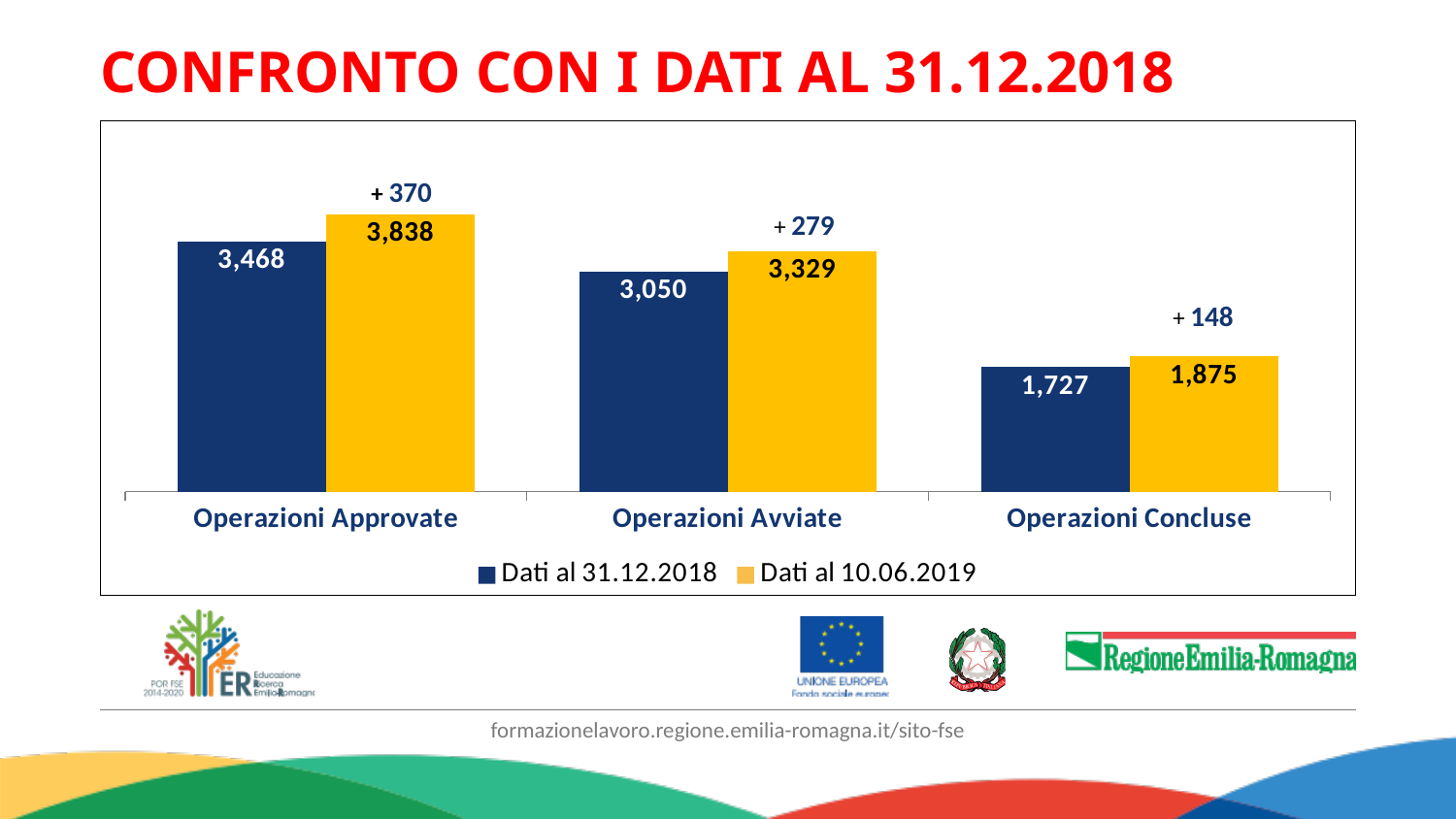
Which category has the lowest value in the Dati al 31.12.2018 series? Operazioni Concluse What is the value for Operazioni Approvate in the Dati al 31.12.2018 series? 3,468 Which is larger: the Dati al 31.12.2018 value for Operazioni Approvate or the Dati al 10.06.2019 value for Operazioni Avviate? Dati al 31.12.2018 value for Operazioni Approvate Which category has the highest value in the Dati al 10.06.2019 series? Operazioni Approvate What is the value for Operazioni Concluse in the Dati al 10.06.2019 series? 1,875 Which colour represents the Dati al 10.06.2019 series? Yellow How many categories are shown on the x axis? 3 What is the value for Operazioni Avviate in the Dati al 10.06.2019 series? 3,329 How many series does the legend list? 2 What is the value for Operazioni Concluse in the Dati al 31.12.2018 series? 1,727 What is the difference between the Dati al 10.06.2019 and Dati al 31.12.2018 values for Operazioni Avviate? 279 What kind of chart is shown on the slide? Bar chart